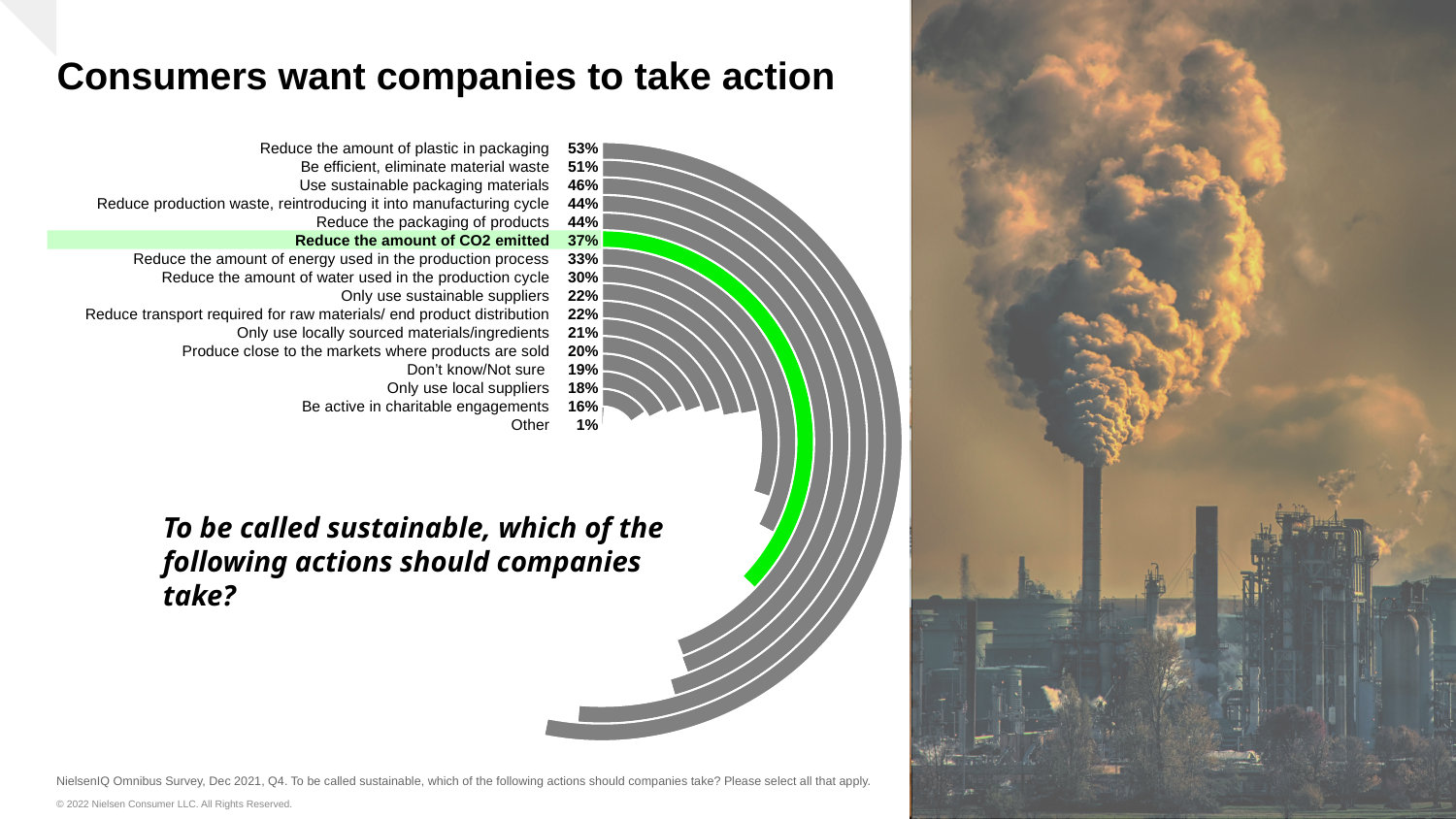
What is the difference between "Reduce the amount of plastic in packaging" and "Be efficient, eliminate material waste"? 2% What is the difference between "Reduce the amount of CO2 emitted" and "Be active in charitable engagements"? 21% What percentage is shown for "Only use local suppliers"? 18% What type of chart is shown on the slide? Doughnut chart (concentric radial arcs) Which action has the highest percentage in the chart? Reduce the amount of plastic in packaging What is the value for "Reduce the amount of CO2 emitted"? 37% Which is larger: "Use sustainable packaging materials" or "Reduce the amount of energy used in the production process"? Use sustainable packaging materials How many categories are shown in the chart? 16 What is the value for "Don't know/Not sure"? 19% Which category is highlighted in green in the chart? Reduce the amount of CO2 emitted What percentage of consumers said companies should reduce the amount of plastic in packaging? 53% Which category has the lowest percentage in the chart? Other